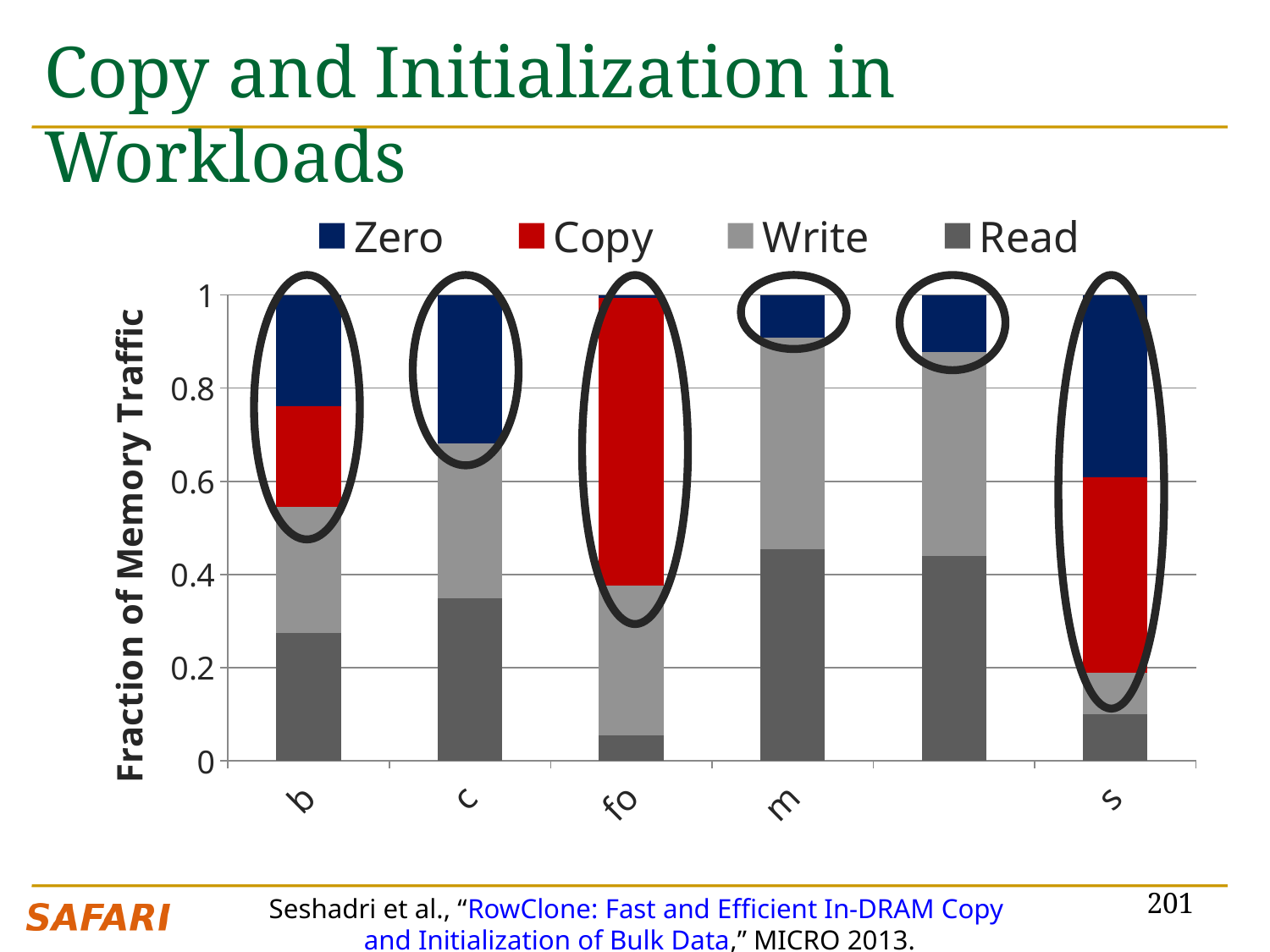
Which colour represents the Copy series in the legend? red Which category has the smallest Read segment? fo Is the Copy value for category fo greater or less than 0.4? greater What kind of chart is shown on the slide? bar chart Which category has the largest Copy segment? fo Is the Read value for category b greater or less than 0.2? greater How many series does the legend list? 4 Which is larger, the Zero segment for category c or the Zero segment for category m? c Is the Zero value for category m greater or less than 0.2? less What is the title of the y axis? Fraction of Memory Traffic How many stacked bars are plotted in the chart? 6